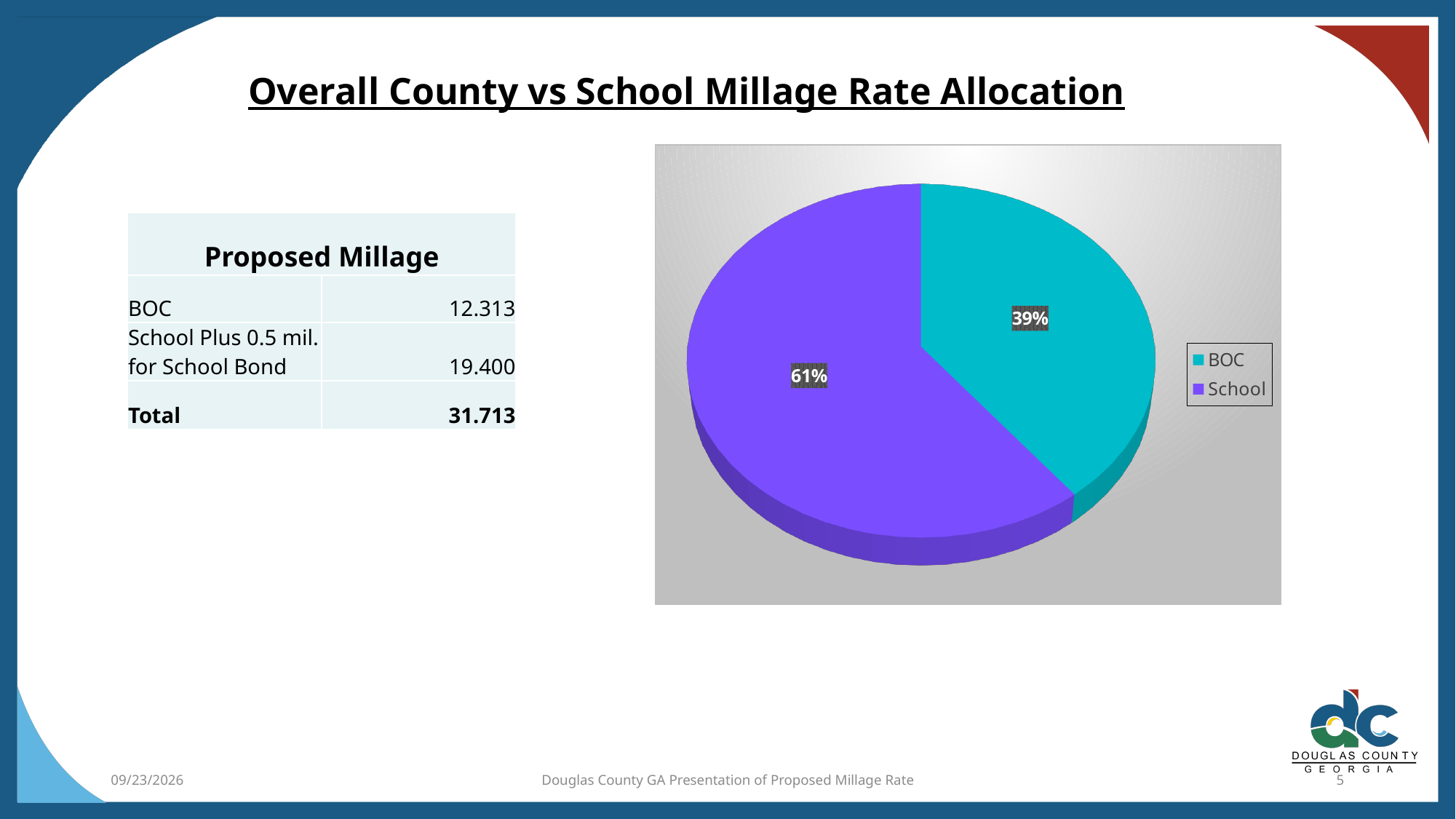
What kind of chart is shown on the slide? pie chart Which slice of the pie is the smallest? BOC How many entries does the legend list? 2 What share of the pie does the BOC slice represent? 39% What is the difference in percentage points between the School slice and the BOC slice? 22% How many slices does the pie chart have? 2 Which is larger in the pie chart, the BOC slice or the School slice? School What colour is the BOC slice in the pie chart? teal What colour is the School slice in the pie chart? purple What share of the pie does the School slice represent? 61% Is the share for School greater or less than 50%? greater Which slice of the pie is the largest? School